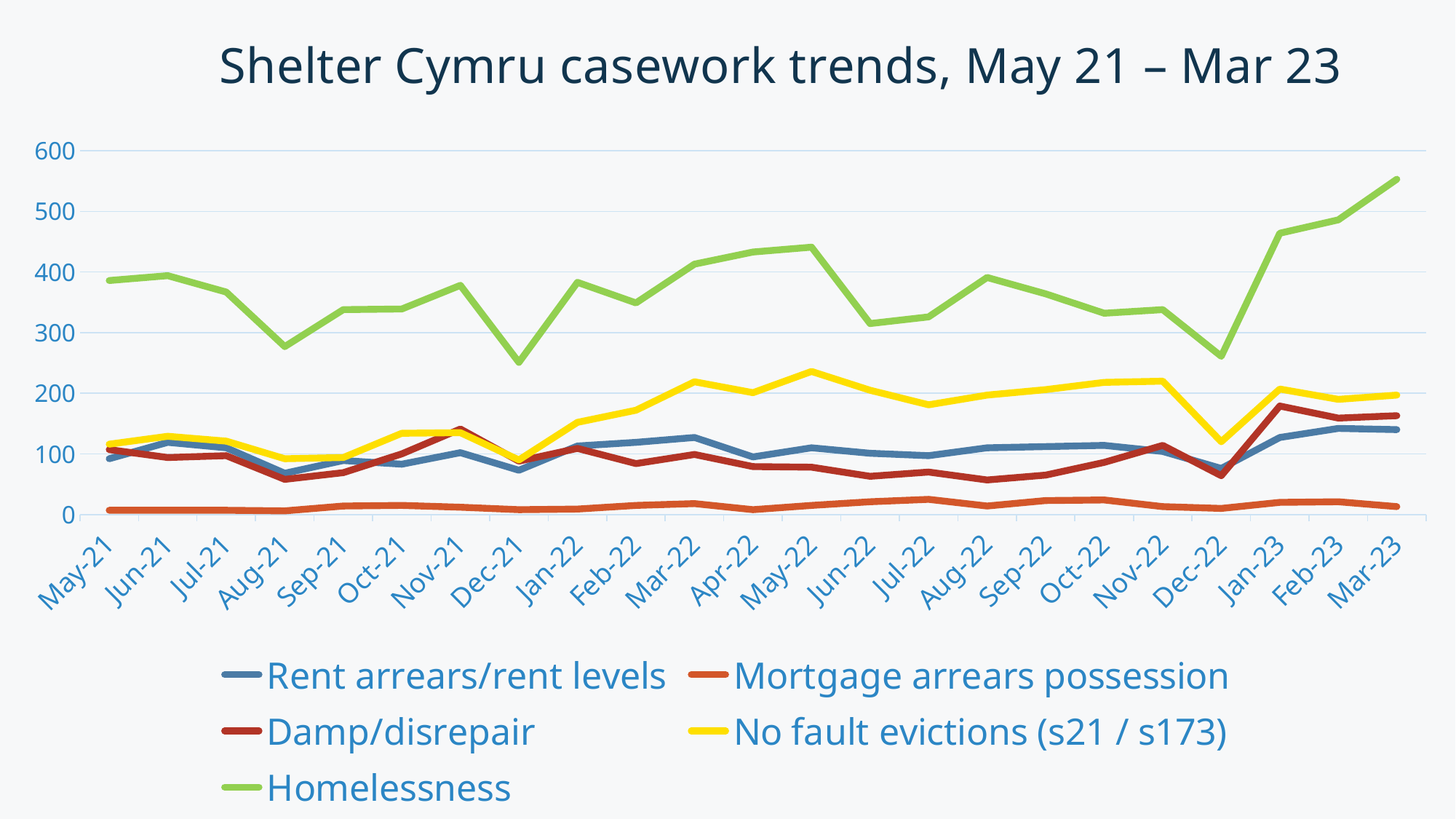
Is the Homelessness value for Dec-21 greater or less than 300? less What kind of chart is shown on the slide? Line chart How many series does the legend list? 5 Is the Mortgage arrears possession value for Jul-22 greater or less than 100? less Is the Homelessness value for Mar-23 greater or less than 500? greater In which month does the Homelessness series reach its highest value? Mar-23 Which is larger in May-22: No fault evictions (s21 / s173) or Damp/disrepair? No fault evictions (s21 / s173) Which series has the highest values across the whole period? Homelessness Which series has the lowest values across the whole period? Mortgage arrears possession Does the Homelessness series rise or fall from Dec-22 to Mar-23? Rise How many months are plotted along the x axis? 23